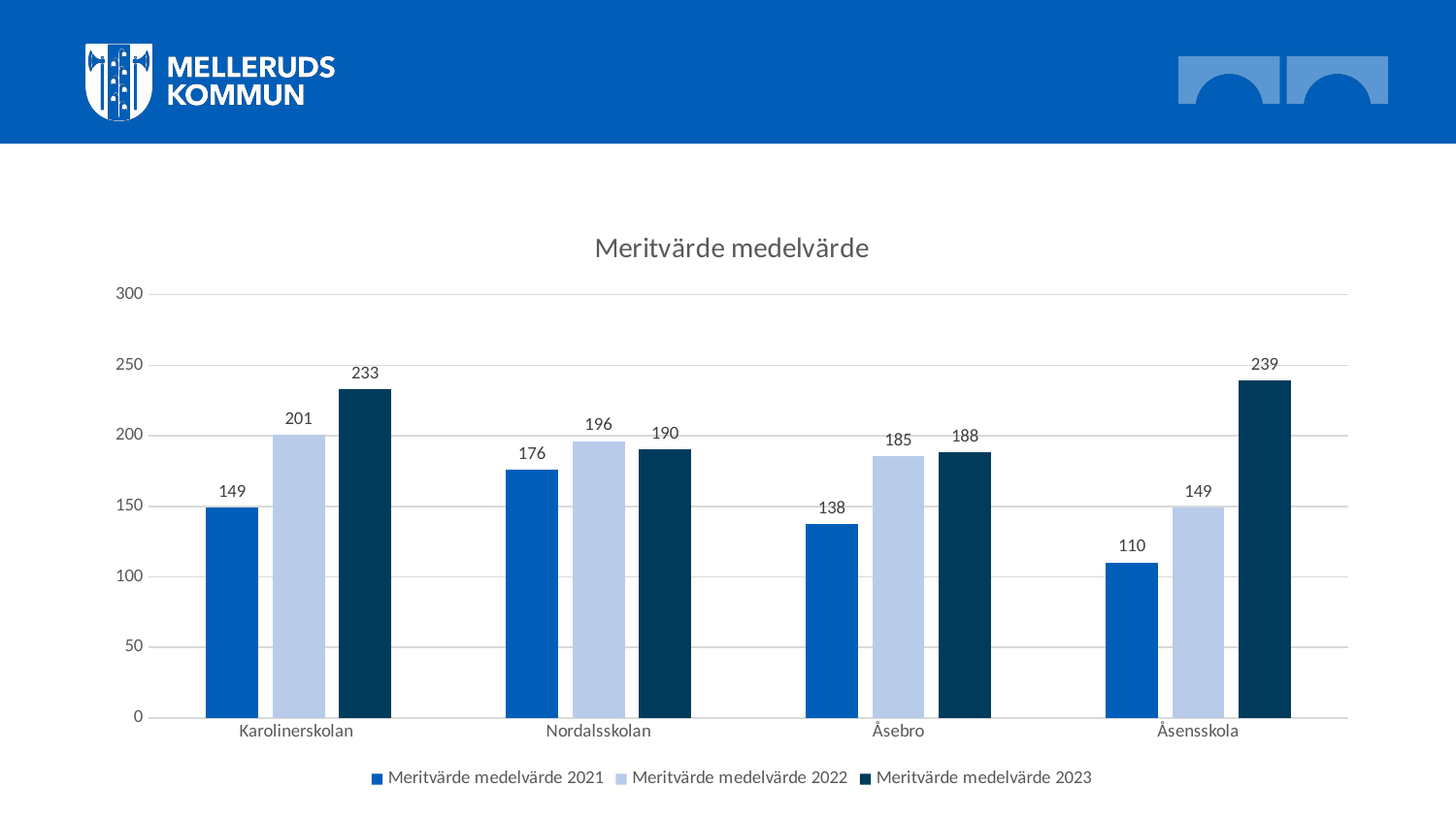
Is the Meritvärde medelvärde 2021 value for Åsebro greater or less than 150? less How many series does the legend list? 3 Which school has the lowest Meritvärde medelvärde 2021 value? Åsensskola How many schools are shown on the x axis? 4 What is the Meritvärde medelvärde 2023 value for Åsensskola? 239 Which is larger for Nordalsskolan: the 2022 value or the 2023 value? 2022 value What is the Meritvärde medelvärde 2021 value for Nordalsskolan? 176 What is the difference between the 2023 and 2021 values for Karolinerskolan? 84 What kind of chart is shown on the slide? bar chart What is the title of the chart? Meritvärde medelvärde Which school has the highest Meritvärde medelvärde 2023 value? Åsensskola What is the Meritvärde medelvärde 2022 value for Åsebro? 185